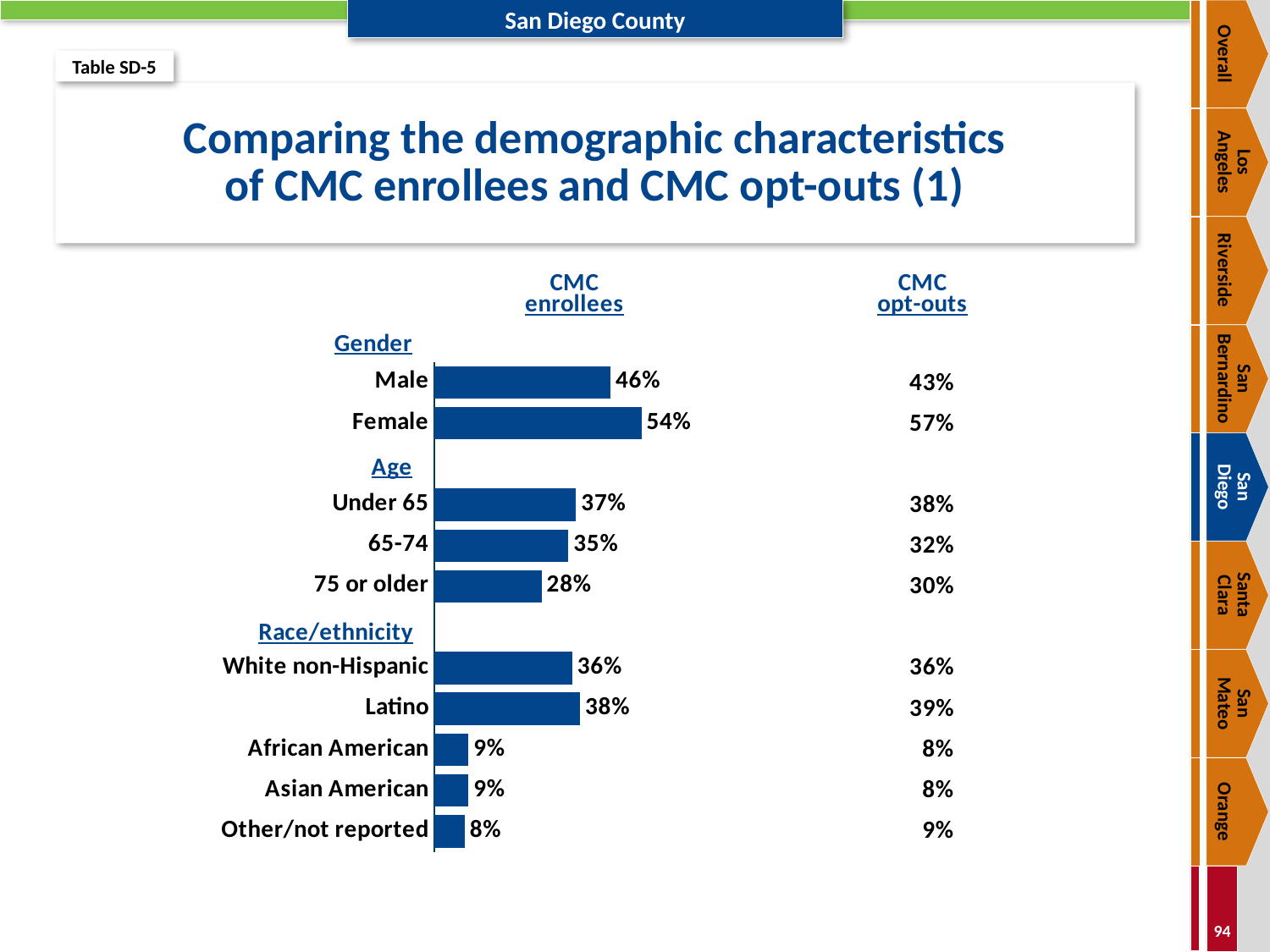
Which is larger for CMC enrollees: Under 65 or 75 or older? Under 65 What percentage of CMC enrollees are Latino? 38% What percentage of CMC enrollees are 75 or older? 28% Which category has the shortest bar for CMC enrollees? Other/not reported What is the difference between the Female and Male percentages for CMC enrollees? 8% What is the title of the slide's chart? Comparing the demographic characteristics of CMC enrollees and CMC opt-outs (1) Which category has the longest bar for CMC enrollees? Female What percentage of CMC opt-outs are Female? 57% What percentage of CMC enrollees are Male? 46% How many categories have bars in the CMC enrollees chart? 10 What kind of chart is used to show the CMC enrollees percentages? Bar chart What is the difference between the CMC enrollees and CMC opt-outs percentages for 65-74? 3%